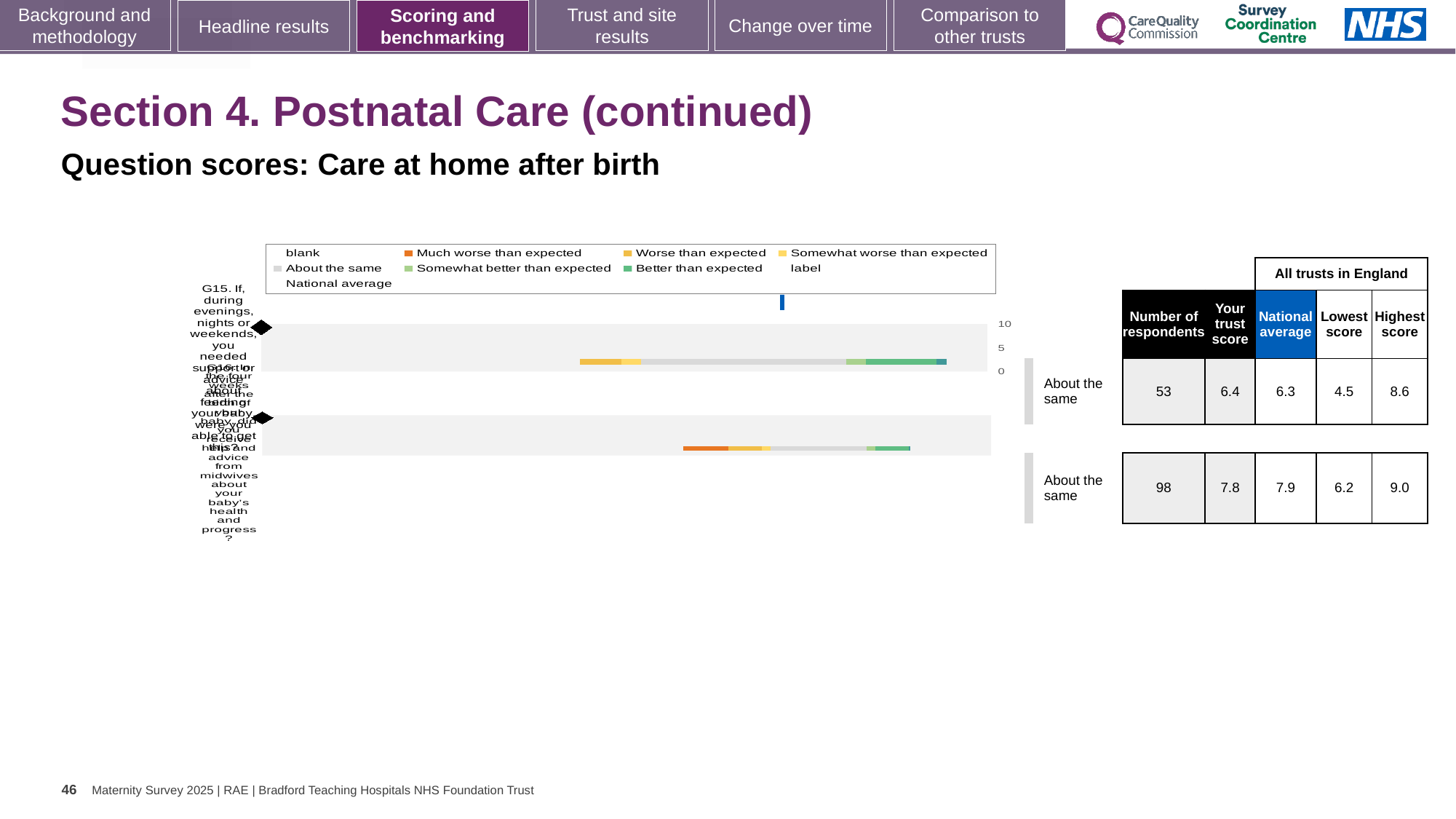
Which is larger for the second row (G16): the trust score or the national average? national average What kind of chart is shown on the slide? bar chart What is the 'Your trust score' for the first row (G15) in the table beside the chart? 6.4 What is the lowest score among all trusts in England for the first row (G15)? 4.5 What is the difference in number of respondents between the second row (G16) and the first row (G15)? 45 What is the highest score among all trusts in England for the second row (G16)? 9.0 What benchmark category is shown next to both bars in the chart? About the same What is the difference between the highest and lowest scores for the first row (G15)? 4.1 What is the number of respondents for the second row (G16) in the table beside the chart? 98 How many question rows (bars) does the chart show? 2 What is the national average for the first row (G15) in the table beside the chart? 6.3 How many entries does the chart legend list? 9